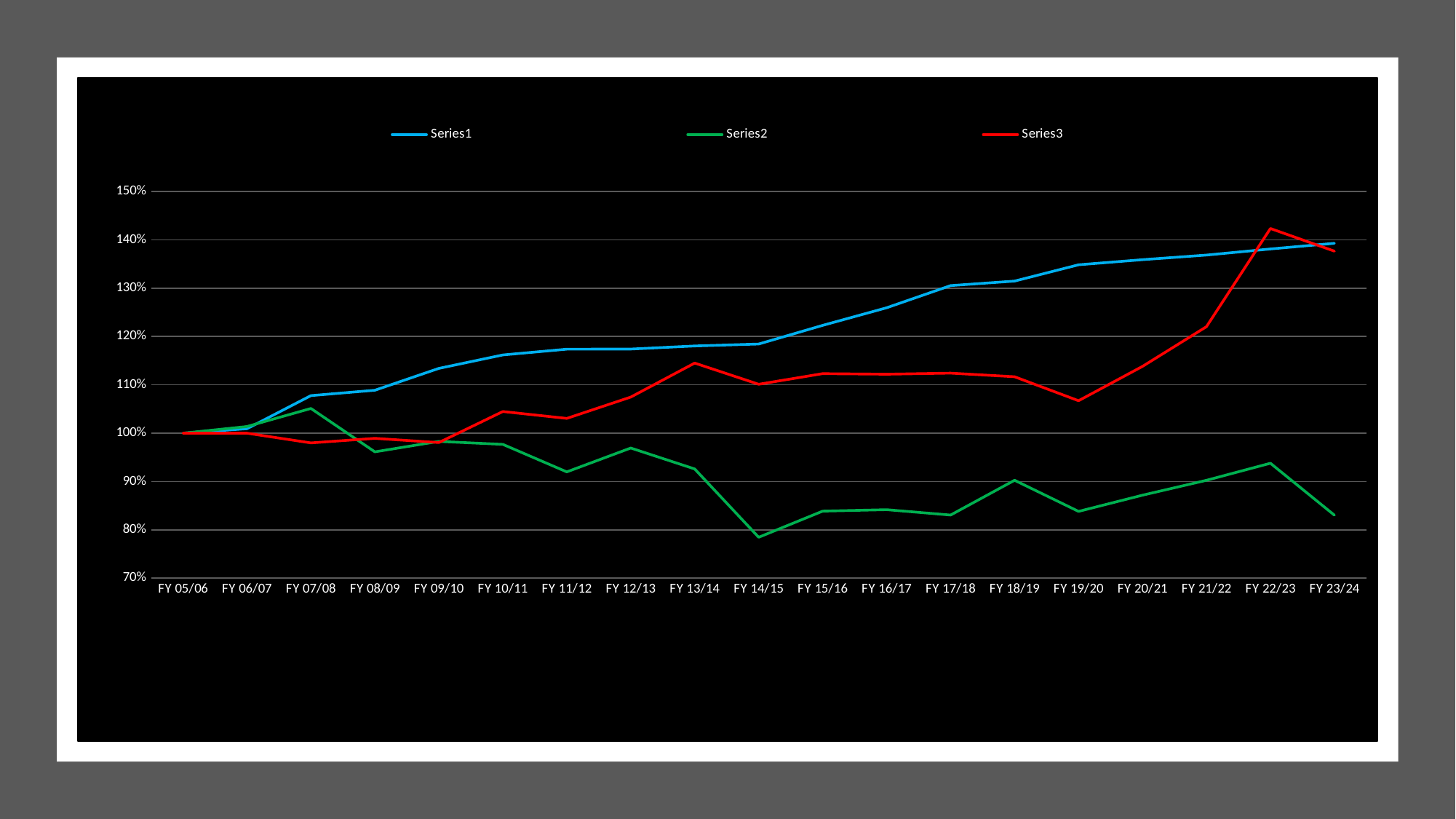
Is the value for Series2 at FY 14/15 greater or less than 80%? less Is the value for Series1 at FY 23/24 greater or less than 130%? greater In which fiscal year does Series2 reach its lowest value? FY 14/15 Does Series1 generally rise or fall from FY 05/06 to FY 23/24? rise At FY 19/20, which is larger, Series1 or Series3? Series1 In which fiscal year does Series3 reach its highest value? FY 22/23 What kind of chart is shown on the slide? line chart Is the value for Series3 at FY 22/23 greater or less than 140%? greater At FY 07/08, which is larger, Series2 or Series3? Series2 How many fiscal years are plotted along the x axis? 19 What is the value of Series1 at FY 05/06? 100% How many series does the legend list? 3